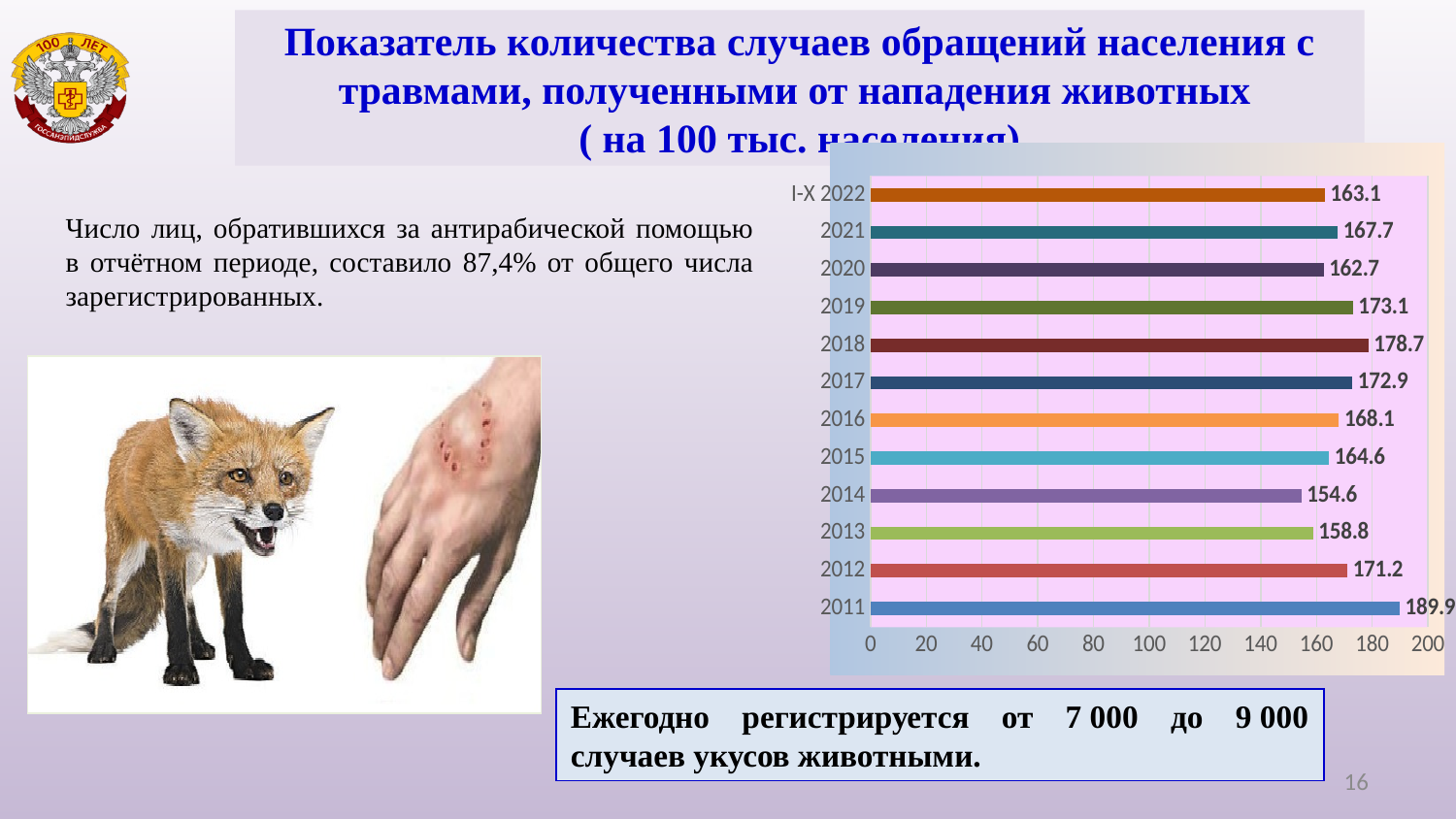
What is the value for I-X 2022 on the chart? 163.1 What kind of chart is shown on the slide? bar chart What is the value for 2014 on the chart? 154.6 Which year has the lowest value on the chart? 2014 Which year has the highest value on the chart? 2011 What is the difference between the values for 2011 and 2014? 35.3 How many categories (periods) are shown on the chart? 12 Do the values rise or fall from 2011 to 2014? fall Which is larger, the value for 2019 or the value for 2020? 2019 What is the value for 2018 on the chart? 178.7 What is the difference between the values for 2018 and 2017? 5.8 Is the value for 2011 greater or less than 180? greater